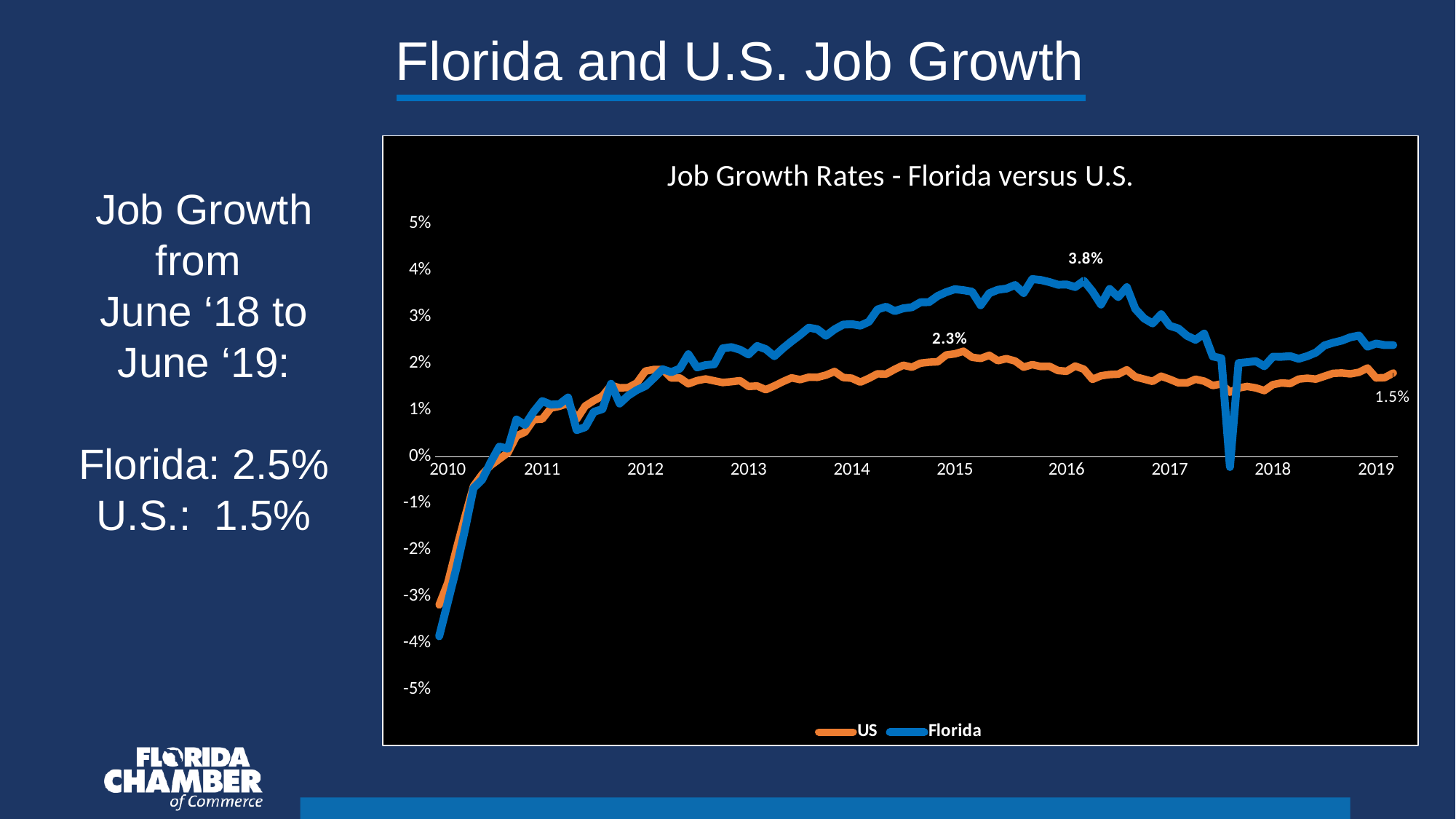
What is the labeled value for the US at the end of the series in 2019? 1.5% What are the two series named in the chart's legend? US and Florida Is the Florida value at the start of 2010 greater or less than -3%? less What is the title of the chart? Job Growth Rates - Florida versus U.S. How many series does the chart's legend list? 2 Which series reaches the higher peak job growth rate, US or Florida? Florida What kind of chart is shown on the slide? line chart What is the difference between Florida's labeled peak (3.8%) and the US labeled peak (2.3%)? 1.5 percentage points What is the labeled peak job growth rate for the US on the chart? 2.3% How many year labels are shown on the x axis? 10 What is the labeled peak job growth rate for Florida on the chart? 3.8%